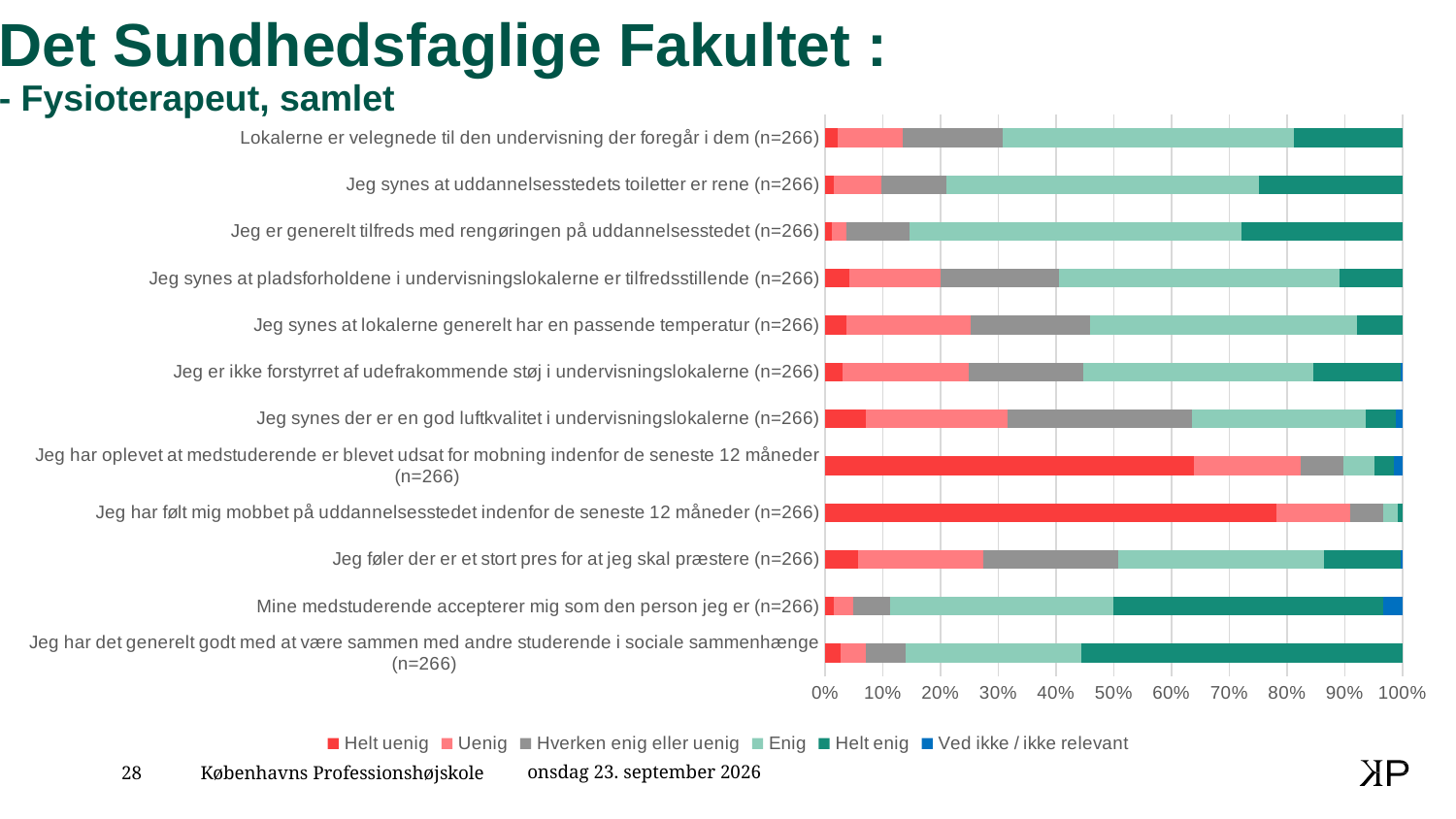
Is the 'Helt uenig' share for 'Lokalerne er velegnede til den undervisning der foregår i dem (n=266)' greater or less than 10%? less Is the 'Helt uenig' share for 'Jeg har følt mig mobbet på uddannelsesstedet indenfor de seneste 12 måneder (n=266)' greater or less than 70%? greater What is the last entry in the chart legend? Ved ikke / ikke relevant Is the 'Helt uenig' share for 'Jeg har oplevet at medstuderende er blevet udsat for mobning indenfor de seneste 12 måneder (n=266)' greater or less than 50%? greater How many statements (categories) are plotted in the chart? 12 Which has the larger 'Helt enig' share: 'Jeg har det generelt godt med at være sammen med andre studerende i sociale sammenhænge (n=266)' or 'Jeg synes at lokalerne generelt har en passende temperatur (n=266)'? Jeg har det generelt godt med at være sammen med andre studerende i sociale sammenhænge (n=266) How many series does the legend list? 6 What kind of chart is shown on the slide? Stacked bar chart Which statement has the largest 'Helt uenig' share? Jeg har følt mig mobbet på uddannelsesstedet indenfor de seneste 12 måneder (n=266) What is the highest value shown on the horizontal axis? 100% Which has the larger 'Helt uenig' share: 'Jeg har følt mig mobbet på uddannelsesstedet indenfor de seneste 12 måneder (n=266)' or 'Jeg synes der er en god luftkvalitet i undervisningslokalerne (n=266)'? Jeg har følt mig mobbet på uddannelsesstedet indenfor de seneste 12 måneder (n=266)